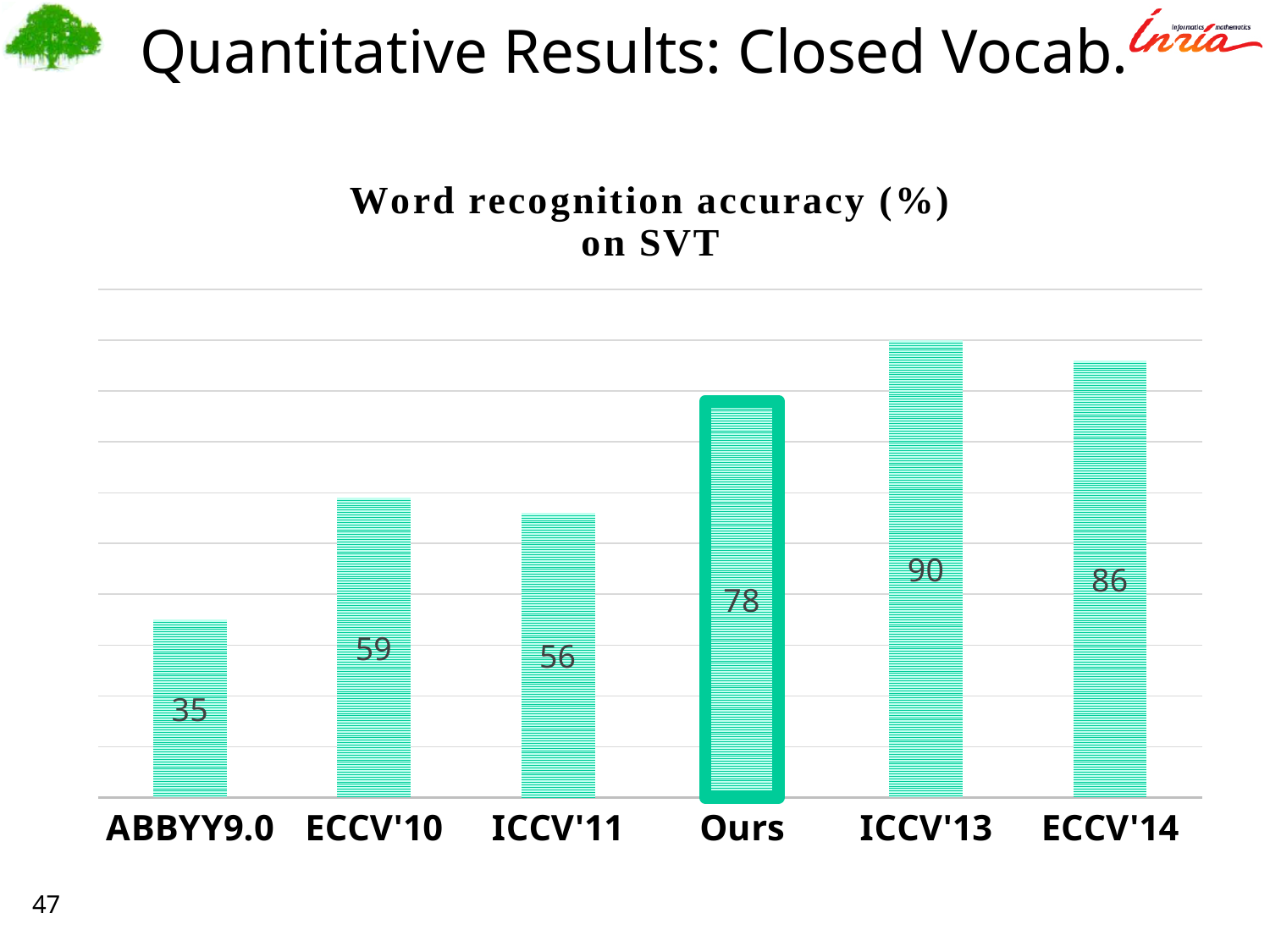
What is the difference in accuracy between ECCV'10 and ICCV'11? 3 How many methods are compared in the chart? 6 Which has a higher accuracy, Ours or ECCV'14? ECCV'14 What is the word recognition accuracy for ECCV'14? 86 What is the word recognition accuracy for ABBYY9.0? 35 Which method has the highest word recognition accuracy? ICCV'13 What kind of chart is shown on the slide? Bar chart What is the title of the chart? Word recognition accuracy (%) on SVT What is the word recognition accuracy for Ours? 78 What is the difference in accuracy between ICCV'13 and Ours? 12 Which method has the lowest word recognition accuracy? ABBYY9.0 Which has a higher accuracy, ECCV'10 or ICCV'11? ECCV'10